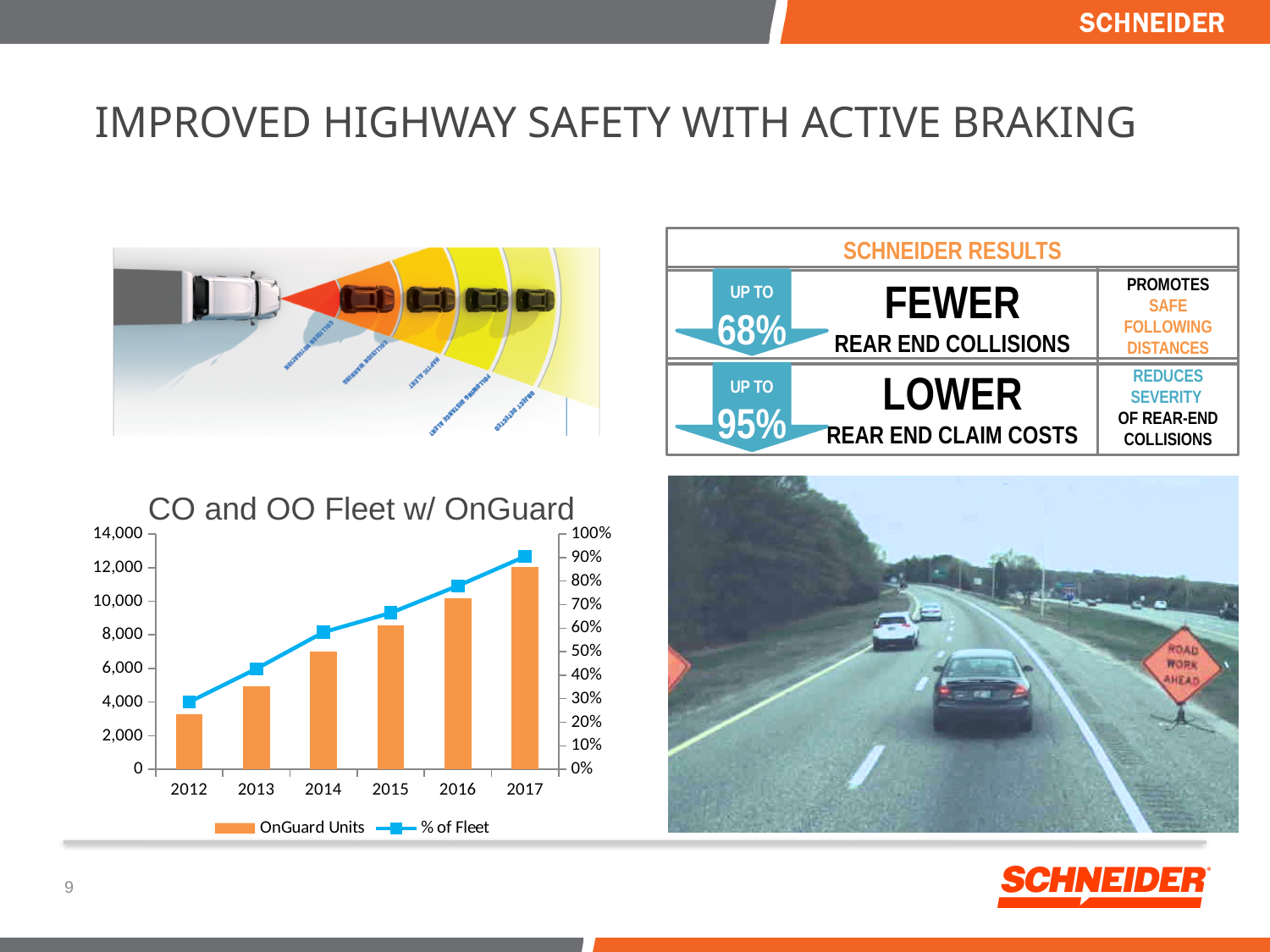
Is the value of OnGuard Units for 2012 greater or less than 4,000? less What is the title of the chart on the slide? CO and OO Fleet w/ OnGuard Is the % of Fleet value for 2017 greater or less than 80%? greater Is the value of OnGuard Units for 2017 greater or less than 10,000? greater Which year has the lowest number of OnGuard Units in the chart? 2012 Which year has the highest number of OnGuard Units in the chart? 2017 How many series does the chart's legend list? 2 Which year has more OnGuard Units in the chart, 2014 or 2016? 2016 Do the OnGuard Units rise or fall from 2012 to 2017 in the chart? rise How many years are shown on the x axis of the chart? 6